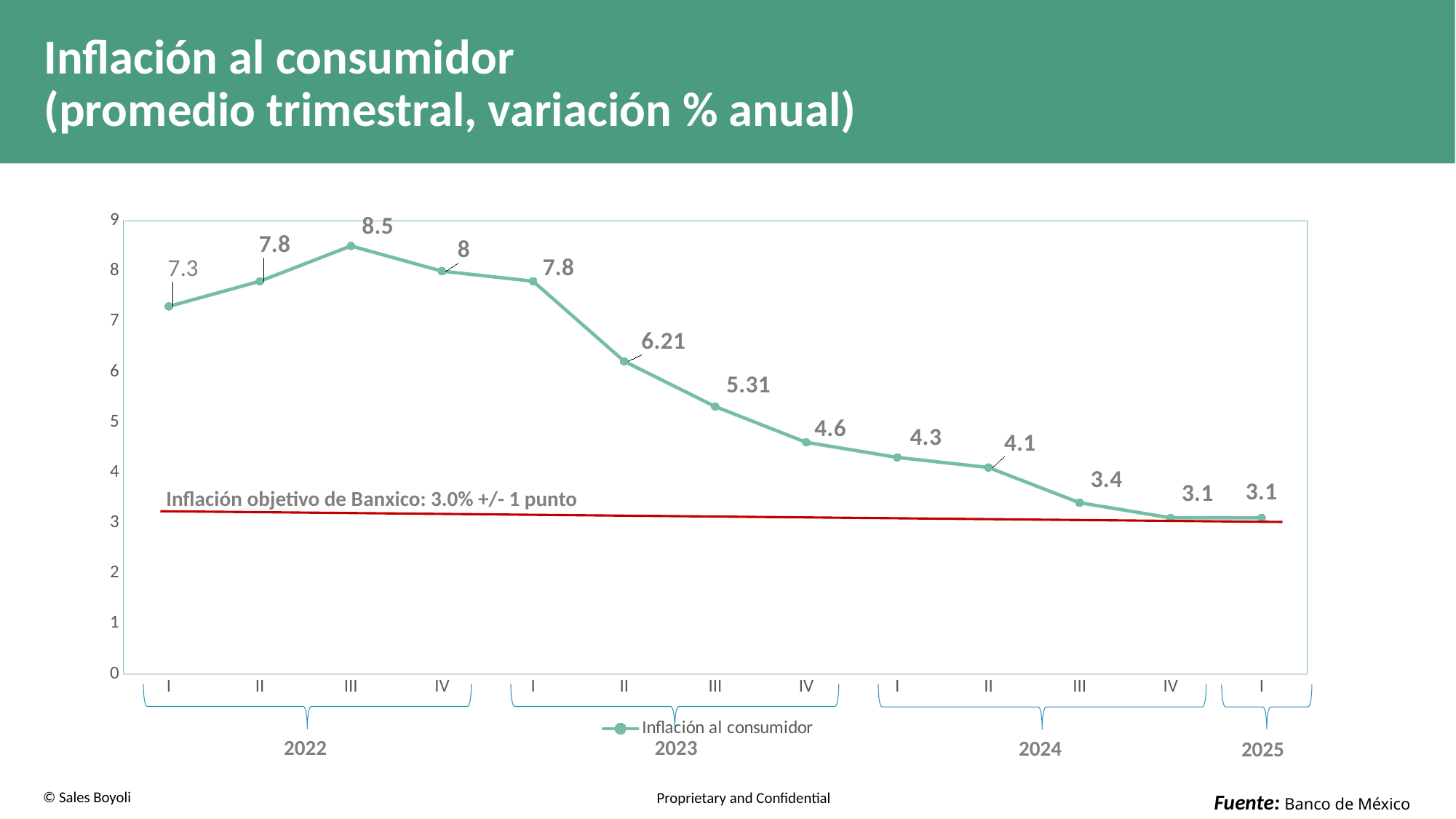
What does the red horizontal line represent? Inflación objetivo de Banxico: 3.0% +/- 1 punto What is the difference between the values for quarter III of 2022 and quarter I of 2025? 5.4 Which quarter has the highest inflation value? III 2022 What kind of chart is shown on the slide? line chart What is the value for quarter III of 2022? 8.5 Is the value for quarter III of 2023 greater or less than 5? greater What is the value for quarter II of 2023? 6.21 Which is larger, the value for quarter IV of 2022 or quarter I of 2023? IV 2022 Do the values rise or fall from quarter I of 2023 to quarter I of 2025? fall How many quarterly data points are plotted on the line? 13 What is the value for quarter III of 2024? 3.4 What is the lowest value shown on the line? 3.1